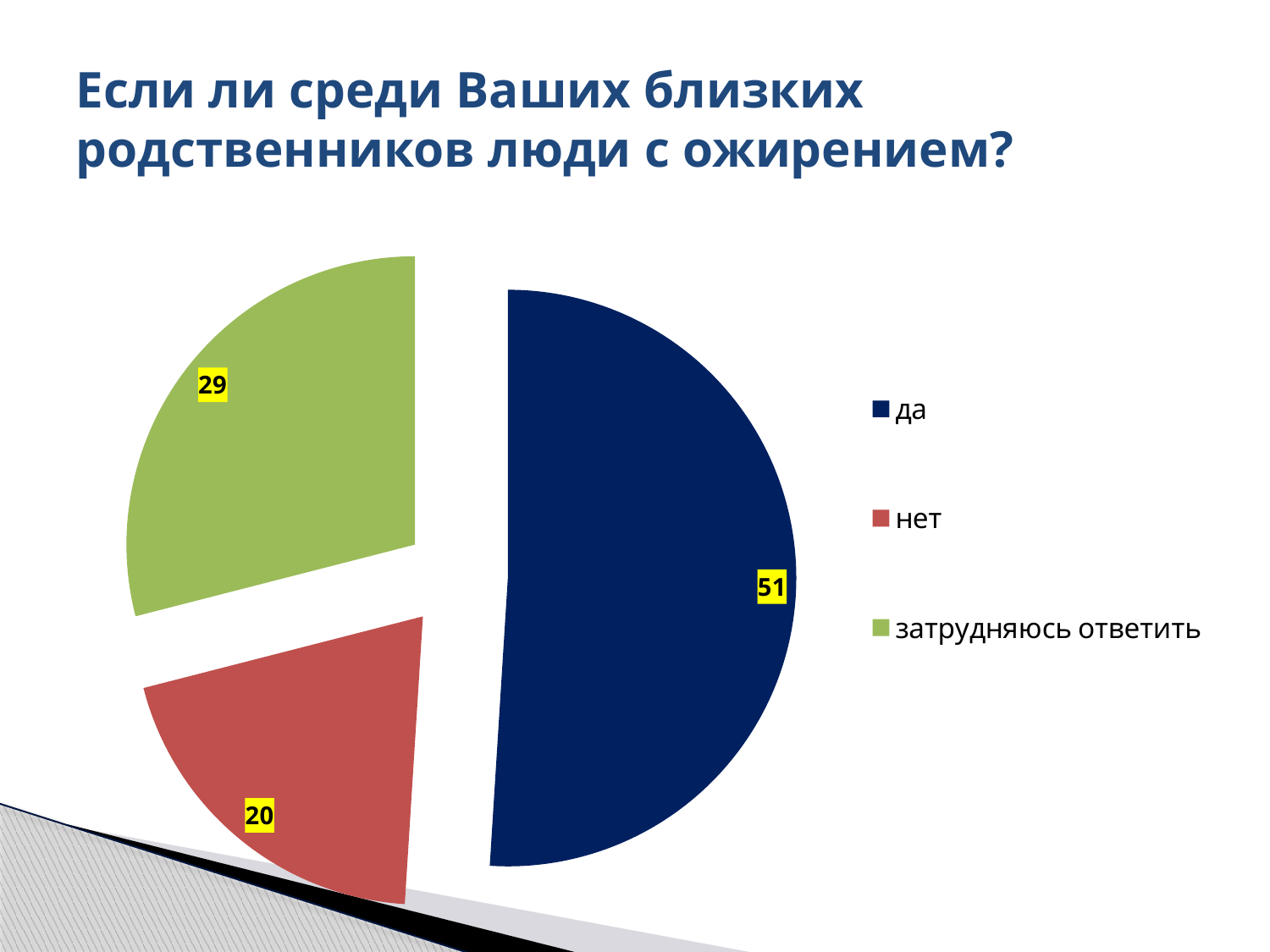
What colour is the "затрудняюсь ответить" slice? green What is the value for "да"? 51 Which category has the largest slice? да Which is larger, the value for "затрудняюсь ответить" or the value for "нет"? затрудняюсь ответить What is the value for "нет"? 20 What kind of chart is shown on the slide? pie chart Which category has the smallest slice? нет What is the difference between the values for "затрудняюсь ответить" and "нет"? 9 What share of the pie does the "да" slice represent? 51% What is the difference between the values for "да" and "нет"? 31 How many slices does the pie chart have? 3 What is the value for "затрудняюсь ответить"? 29